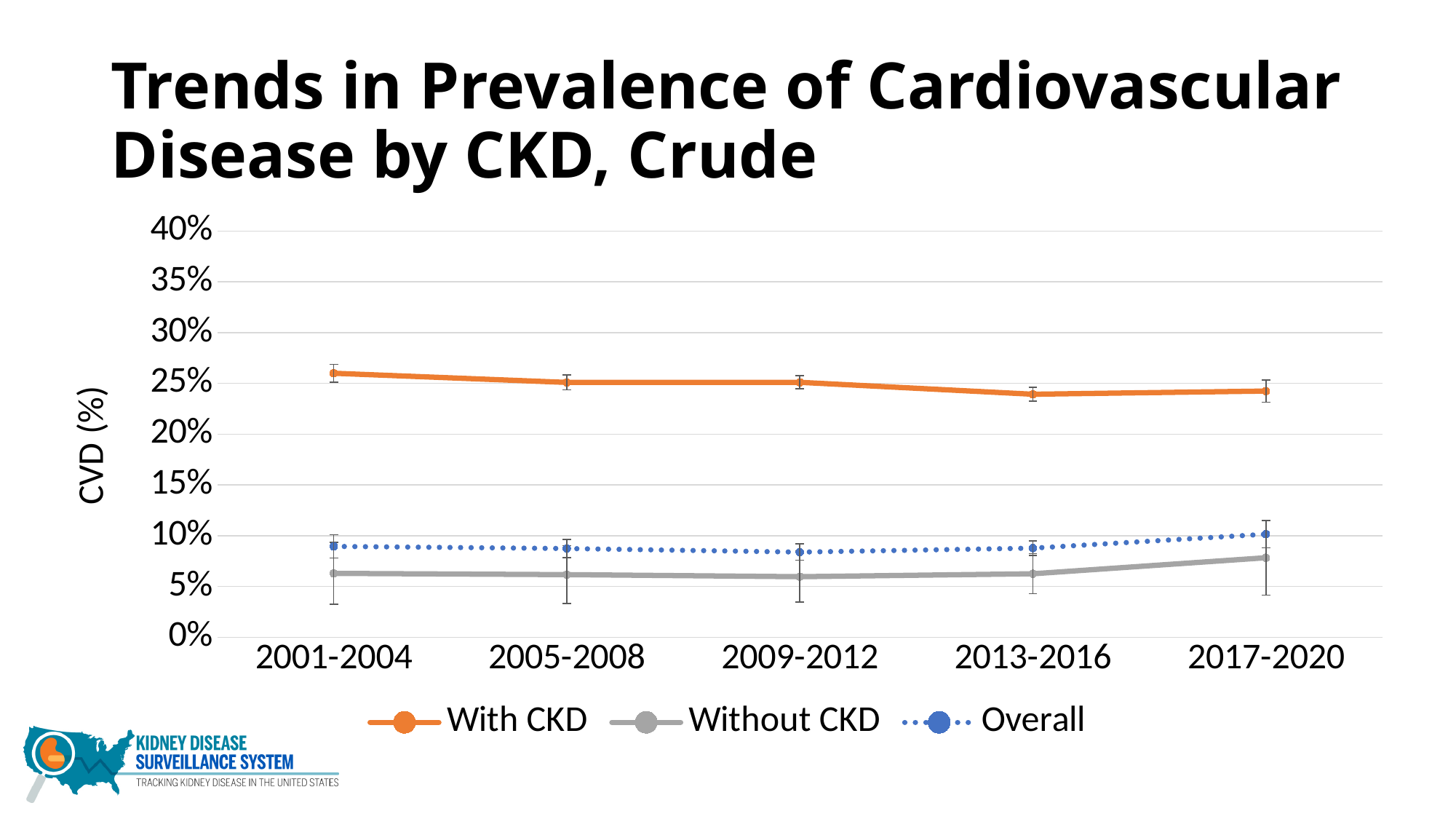
Is the value for Overall in 2001-2004 greater or less than 5%? greater Which series has the higher value in 2017-2020, With CKD or Without CKD? With CKD Which series has the lower value in 2005-2008, Without CKD or Overall? Without CKD Is the value for With CKD in 2001-2004 greater or less than 25%? greater Is the value for Without CKD in 2009-2012 greater or less than 10%? less Does the With CKD series generally rise or fall from 2001-2004 to 2017-2020? fall How many time periods are shown on the x axis? 5 In which period is the Without CKD series highest? 2017-2020 What kind of chart is shown on the slide? line chart How many series does the legend list? 3 What is the label on the y axis? CVD (%)